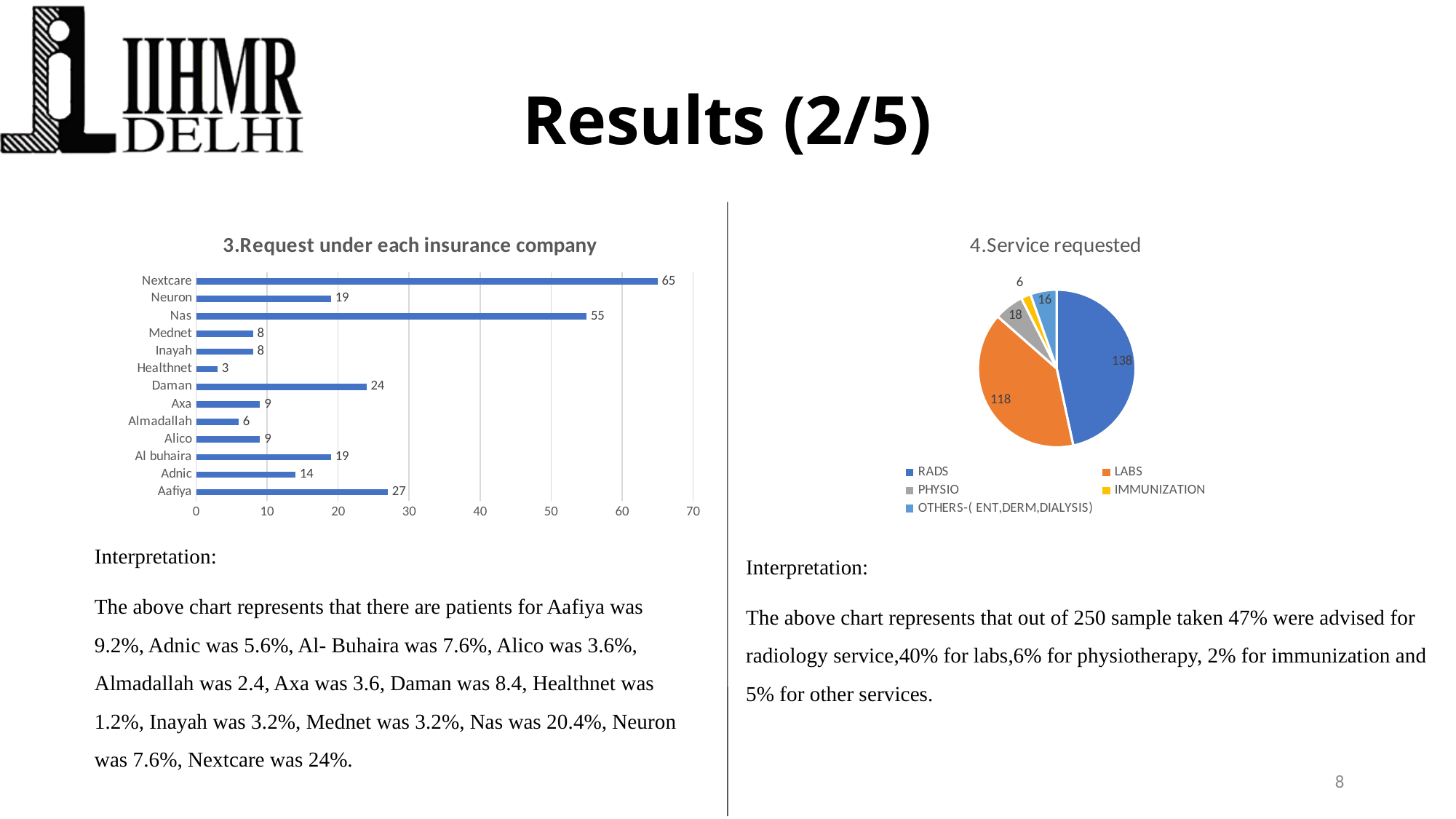
In the chart '4.Service requested', which service has the largest slice? RADS What type of chart is '3.Request under each insurance company'? Bar chart In the chart '3.Request under each insurance company', which insurance company has the highest value? Nextcare How many categories does the legend of the chart '4.Service requested' list? 5 In the chart '3.Request under each insurance company', what is the value for Nextcare? 65 In the chart '4.Service requested', what is the difference between the values for RADS and LABS? 20 In the chart '3.Request under each insurance company', what is the value for Daman? 24 How many insurance companies are shown in the chart '3.Request under each insurance company'? 13 In the chart '4.Service requested', what is the value for LABS? 118 In the chart '3.Request under each insurance company', which is larger, the value for Aafiya or the value for Adnic? Aafiya In the chart '3.Request under each insurance company', which insurance company has the lowest value? Healthnet In the chart '3.Request under each insurance company', what is the difference between the values for Nextcare and Nas? 10